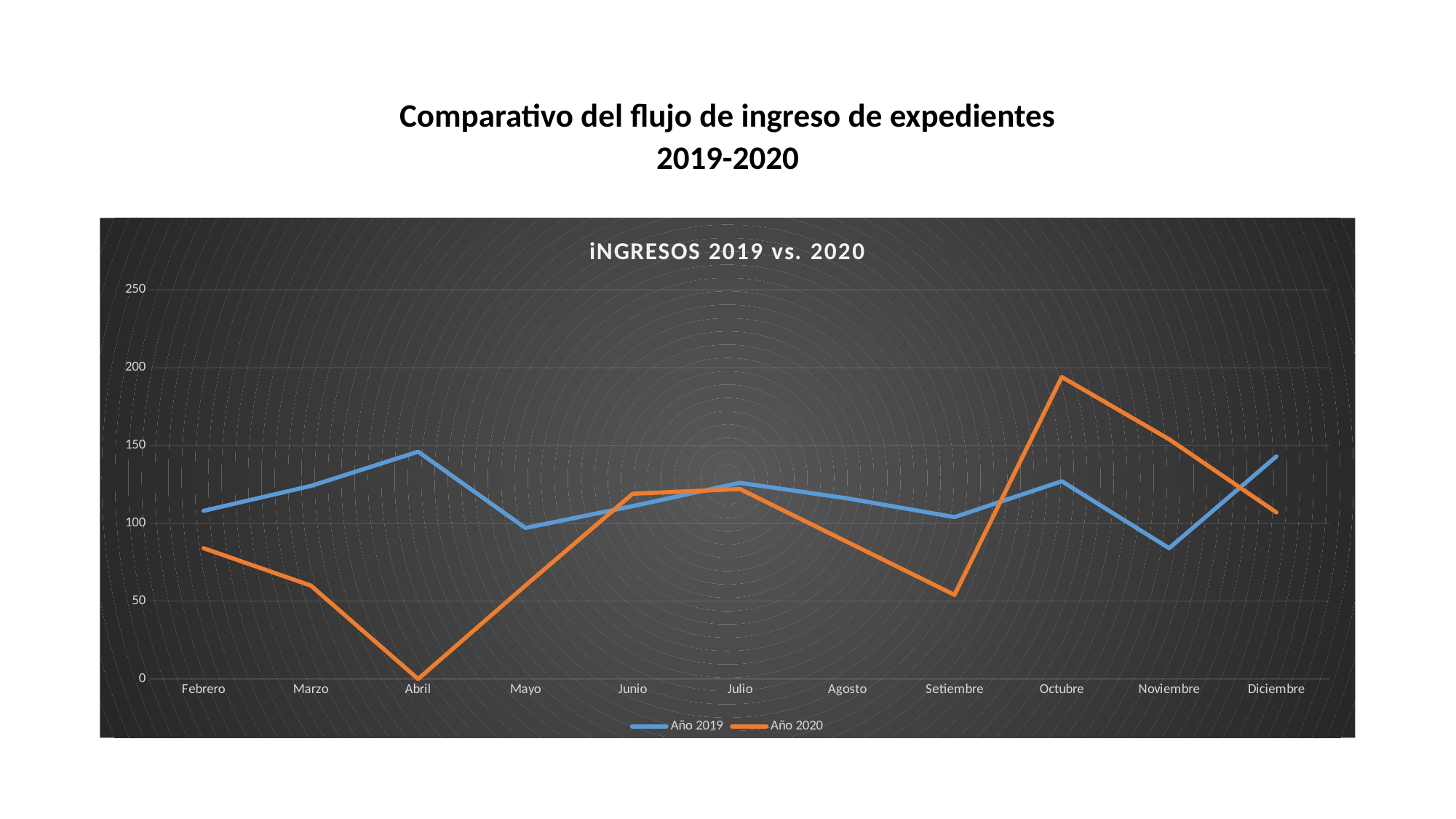
How many months are shown on the x axis? 11 Is the value for Año 2019 in Noviembre greater or less than 100? less Does the Año 2020 line rise or fall from Julio to Setiembre? fall How many series does the legend list? 2 In Octubre, which series has the larger value, Año 2019 or Año 2020? Año 2020 Is the value for Año 2020 in Octubre greater or less than 150? greater In which month does Año 2019 reach its lowest value? Noviembre In which month does Año 2020 reach its lowest value? Abril What kind of chart is shown on the slide? line chart In which month does Año 2020 reach its highest value? Octubre What is the value for Año 2020 in Abril? 0 What is the title shown inside the chart area? iNGRESOS 2019 vs. 2020